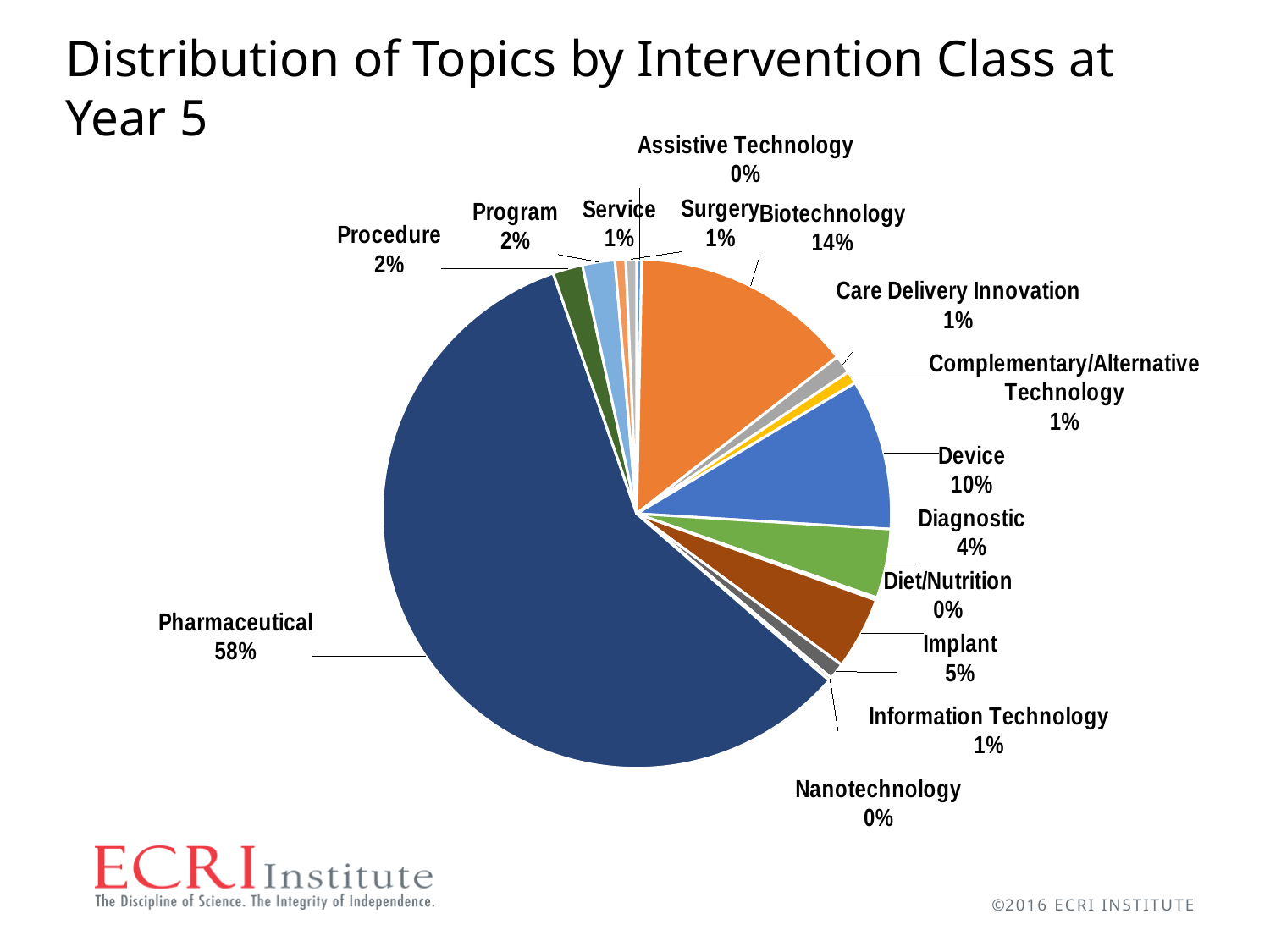
What share of the pie does Pharmaceutical account for? 58% How many intervention classes are labelled on the pie chart? 15 What is the difference between the Pharmaceutical share and the Biotechnology share? 44% Which is larger, the share for Device or the share for Diagnostic? Device What is the value shown for Device? 10% What kind of chart is shown on the slide? Pie chart What is the title of the slide? Distribution of Topics by Intervention Class at Year 5 What is the difference between the Device share and the Implant share? 5% Which intervention class has the largest share of the pie? Pharmaceutical What is the value shown for Biotechnology? 14% What is the value shown for Implant? 5% What is the value shown for Diagnostic? 4%